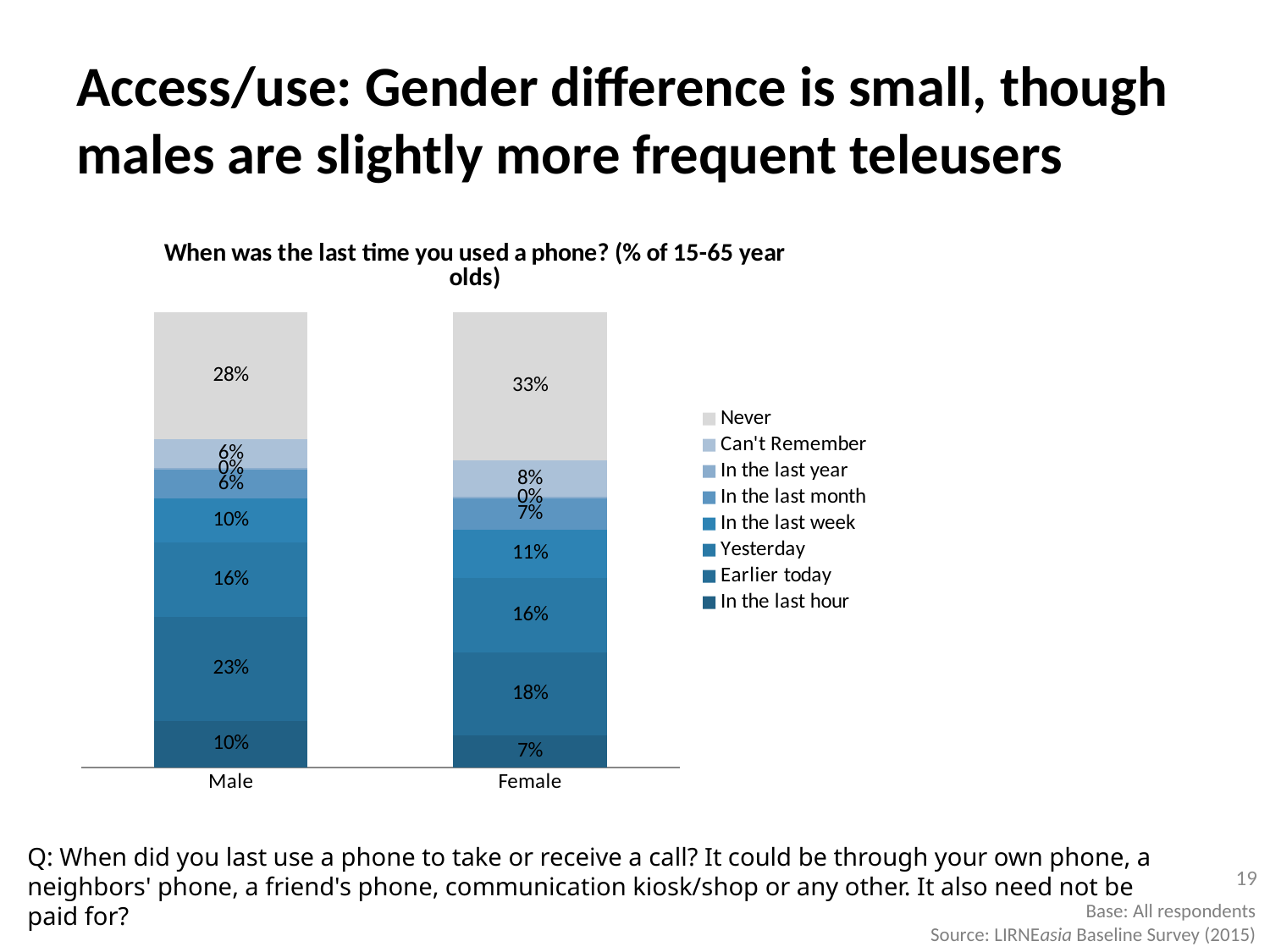
How many categories (bars) are shown on the x axis? 2 How many series does the legend list? 8 What percentage of females answered "Never"? 33% What is the value for "Earlier today" among males? 23% Which gender has the larger share for "Earlier today"? Male What percentage of males answered "Never"? 28% What is the value for "Yesterday" among females? 16% What is the value for "In the last hour" among females? 7% What kind of chart is shown on the slide? Stacked bar chart What is the title of the chart? When was the last time you used a phone? (% of 15-65 year olds) What is the difference between the "Never" share for females and for males? 5 percentage points Which response is the largest segment in the Female bar? Never